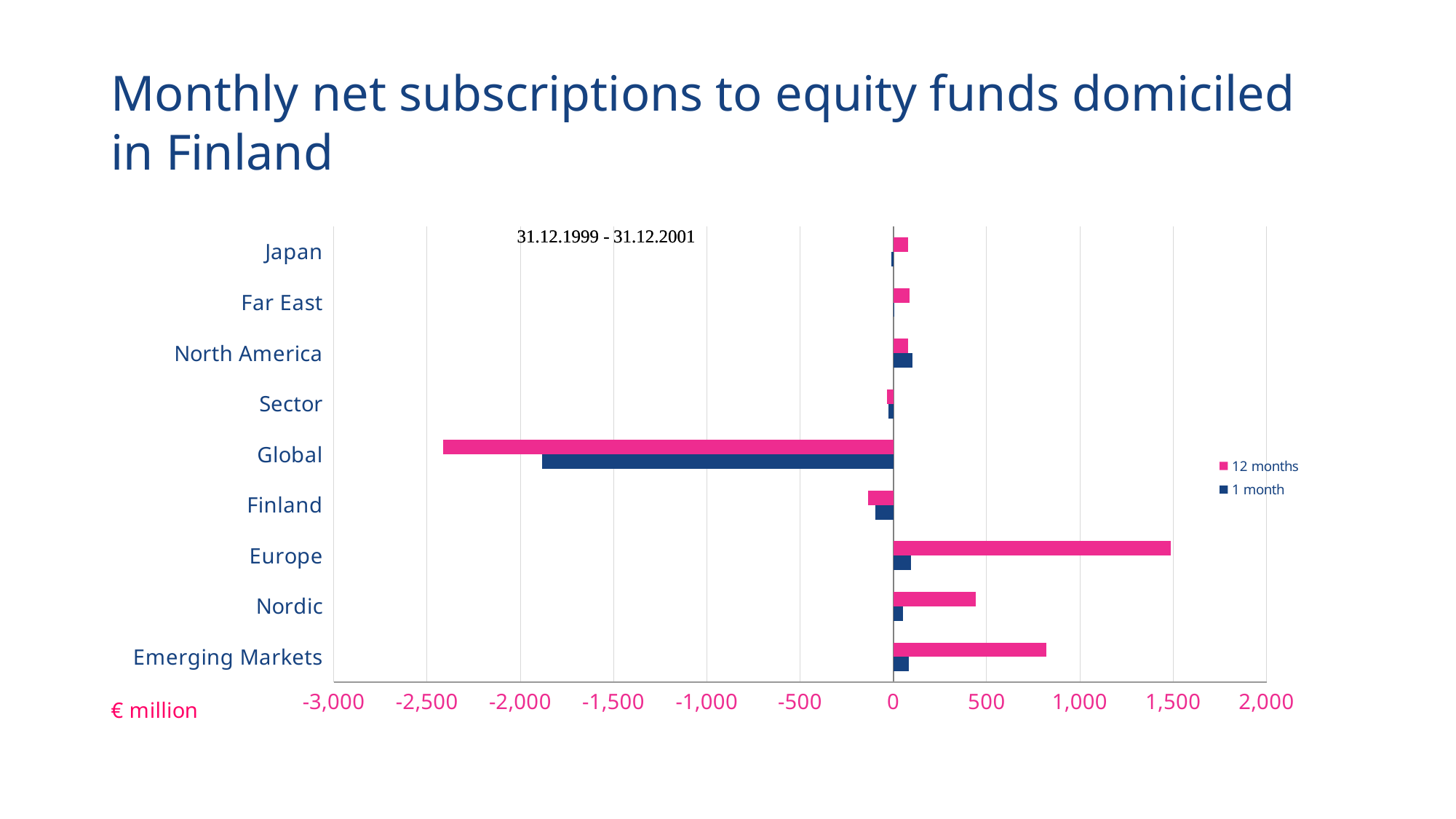
Which category has the lowest 1 month value? Global How many series does the legend list? 2 Is the 12 months value for Emerging Markets greater or less than 500? greater Is the 12 months value for Global greater or less than -2,000? less Which category has the highest 12 months value? Europe Is the 12 months value for Europe greater or less than 1,000? greater What unit is shown for the horizontal axis? € million How many categories are shown on the chart? 9 Which category has the lowest 12 months value? Global Which is larger, the 12 months value for Europe or the 12 months value for Emerging Markets? Europe What kind of chart is shown on the slide? bar chart